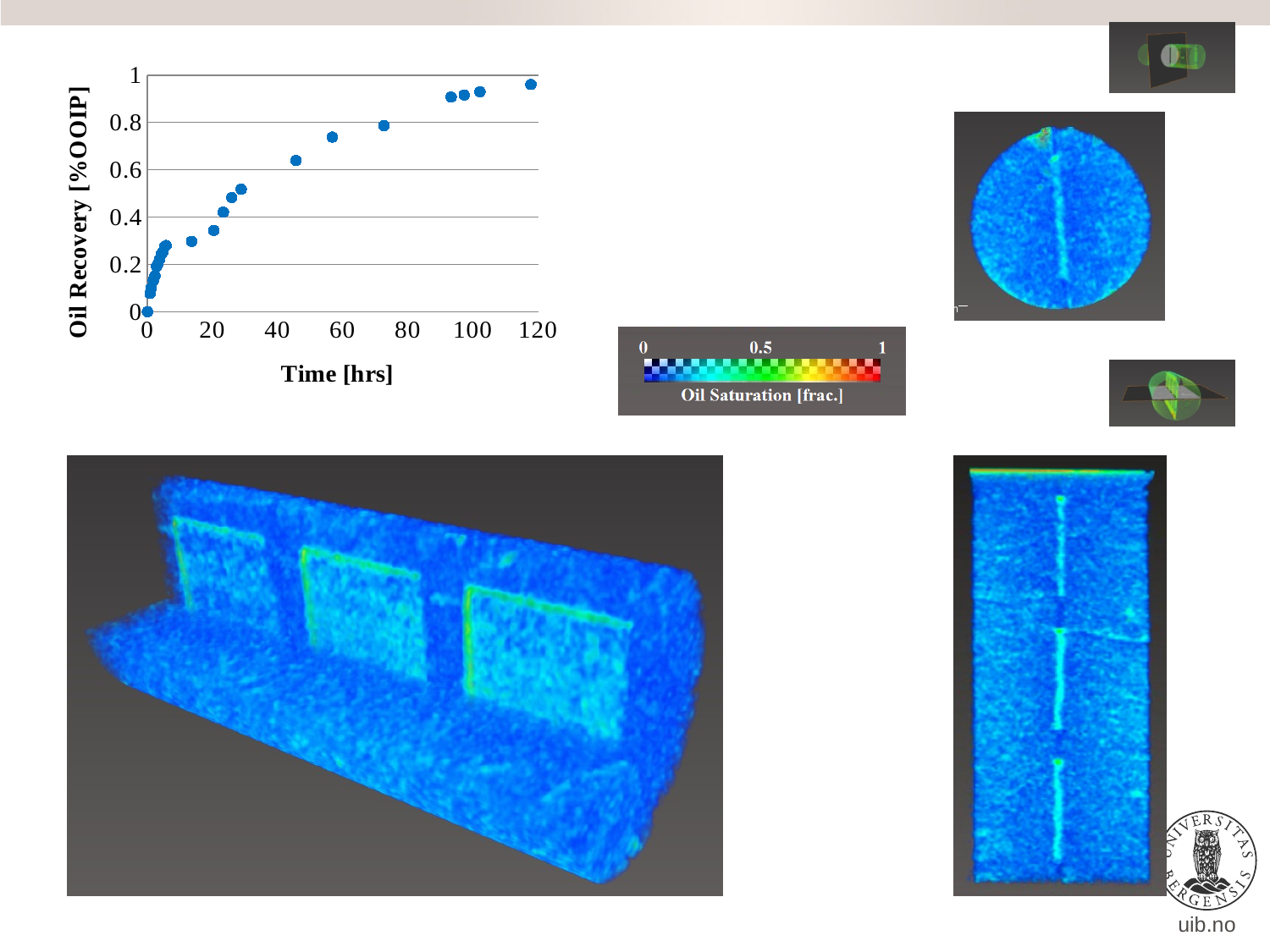
What is the label of the y axis of the chart? Oil Recovery [%OOIP] What is the oil recovery value at time 0 hours? 0 Does oil recovery rise or fall as time increases along the x axis? Rise What is the label of the x axis of the chart? Time [hrs] Is the oil recovery of the data point near 60 hours greater or less than 0.8? less What kind of chart is shown on the slide? Scatter chart Is the oil recovery of the data point near 100 hours greater or less than 0.8? greater Which data point has the highest oil recovery: the one near 60 hours or the one near 100 hours? The one near 100 hours Is the oil recovery of the data point near 20 hours greater or less than 0.4? less What is the highest value shown on the x axis of the chart? 120